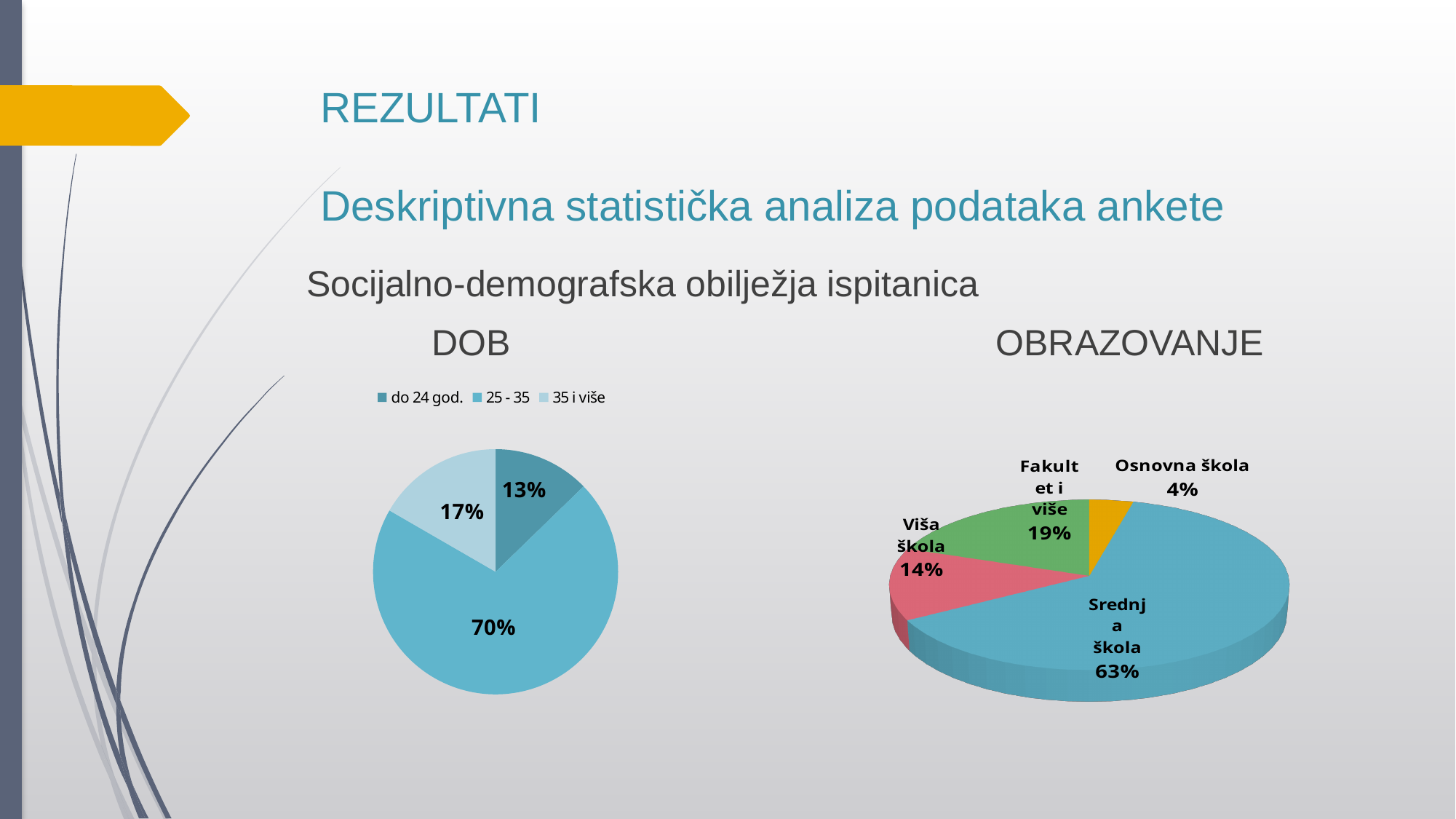
In the DOB chart, which age group has the smallest share? do 24 god. In the DOB chart, what share of respondents are in the 25 - 35 group? 70% In the DOB chart, what percentage is shown for the 'do 24 god.' slice? 13% In the OBRAZOVANJE chart, what percentage is shown for Osnovna škola? 4% How many slices does the OBRAZOVANJE chart have? 4 How many entries does the legend of the DOB chart list? 3 In the DOB chart, what percentage is shown for '35 i više'? 17% In the OBRAZOVANJE chart, what is the difference between Fakultet i više and Viša škola? 5% In the OBRAZOVANJE chart, what percentage is shown for Srednja škola? 63% In the DOB chart, which age group has the largest share? 25 - 35 In the OBRAZOVANJE chart, which category has the smallest share? Osnovna škola What type of chart is the OBRAZOVANJE chart? Pie chart